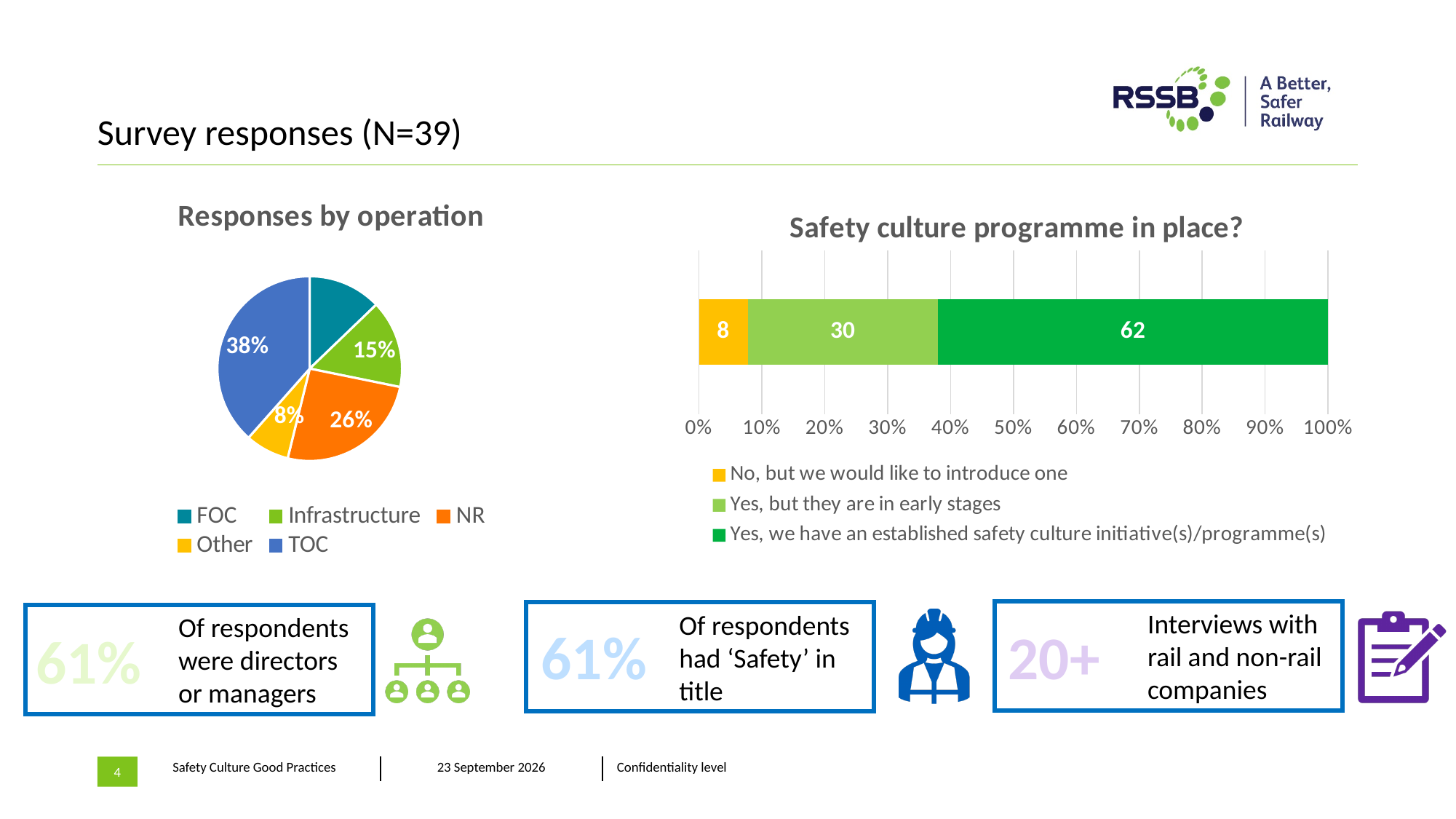
In the 'Responses by operation' pie chart, how many percentage points larger is the NR share than the Infrastructure share? 11 percentage points How many categories does the legend of the 'Responses by operation' chart list? 5 In the 'Safety culture programme in place?' chart, what is the value for 'Yes, we have an established safety culture initiative(s)/programme(s)'? 62 In the 'Responses by operation' pie chart, what percentage of responses came from NR? 26% What kind of chart is 'Responses by operation'? Pie chart In the 'Responses by operation' pie chart, which category has the largest share? TOC How many series does the legend of the 'Safety culture programme in place?' chart list? 3 In the 'Safety culture programme in place?' chart, what is the value for 'No, but we would like to introduce one'? 8 In the 'Responses by operation' pie chart, what percentage of responses came from Infrastructure? 15% In the 'Responses by operation' pie chart, which is larger: the Infrastructure share or the Other share? Infrastructure In the 'Responses by operation' pie chart, which category has the smallest share? Other In the 'Responses by operation' pie chart, what percentage of responses came from TOC? 38%